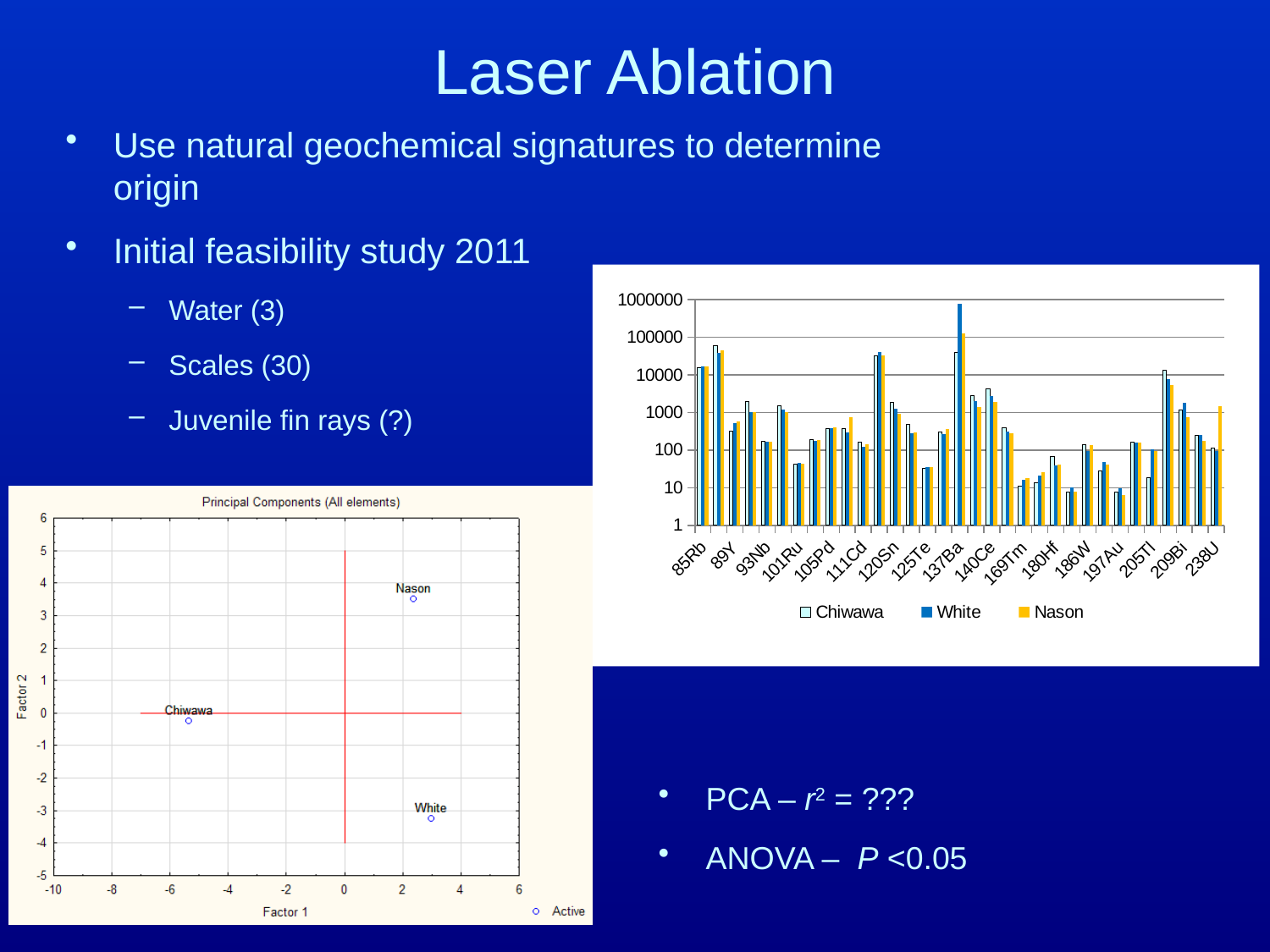
What kind of chart is the chart on the right with the legend Chiwawa, White and Nason? bar chart In the Principal Components chart, is the Factor 1 value for Chiwawa greater or less than -4? less In the bar chart on the right, what is the highest value shown on the vertical axis? 1000000 In the bar chart on the right, how many series does the legend list? 3 In the Principal Components chart, which point has the highest Factor 2 value? Nason In the bar chart on the right, is the tallest bar (White at 137Ba) greater or less than 100000? greater In the bar chart on the right, which series has the tallest bar in the whole chart? White What is the title of the chart at the bottom left? Principal Components (All elements) In the Principal Components chart, which point has the lowest Factor 2 value? White In the Principal Components chart, which point has the lowest Factor 1 value? Chiwawa In the Principal Components chart, how many labelled points are plotted? 3 What kind of chart is the Principal Components chart at the bottom left? scatter plot